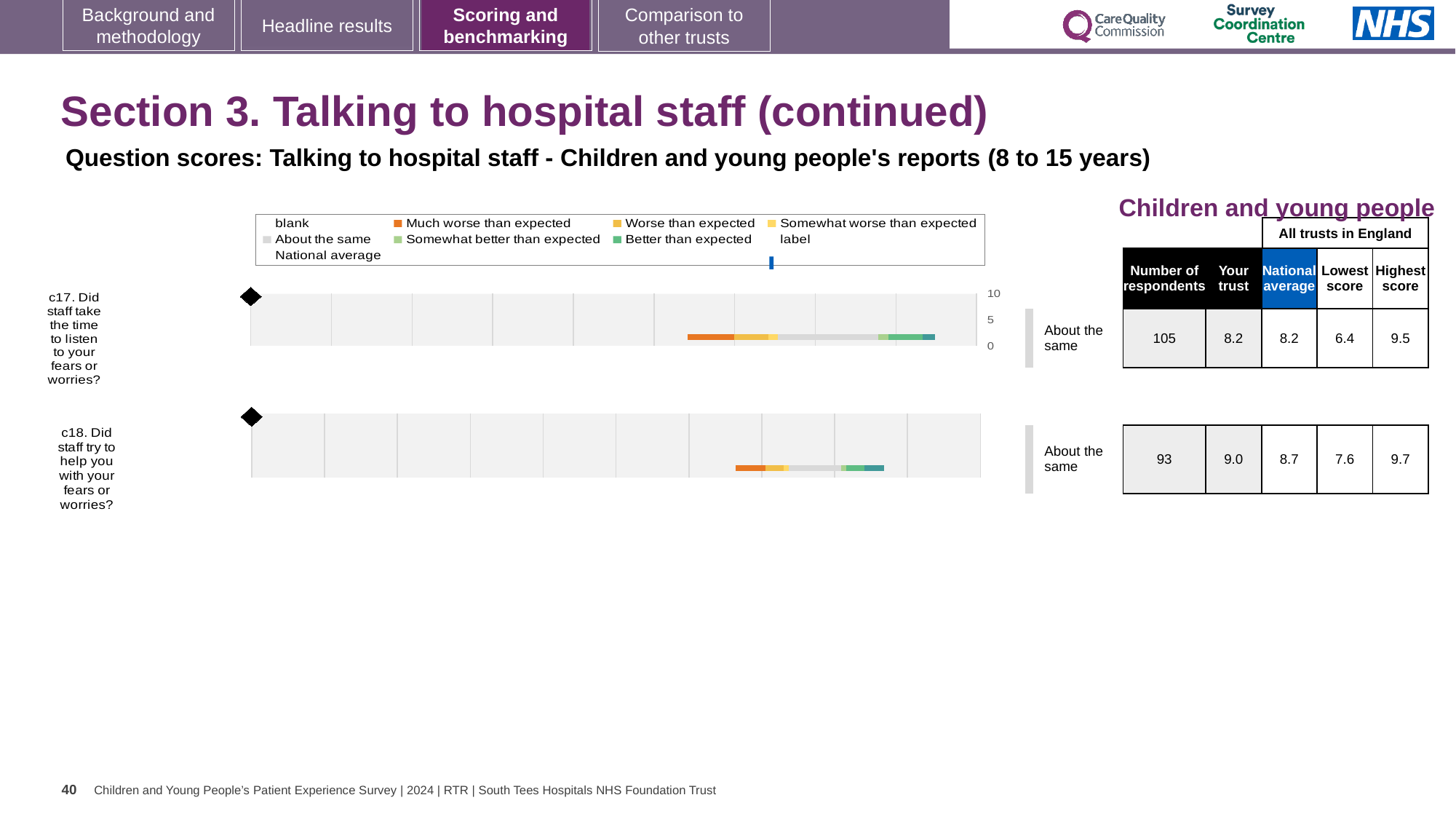
What is the trust's score for question c17 (Did staff take the time to listen to your fears or worries?)? 8.2 What is the national average score for question c18 (Did staff try to help you with your fears or worries?)? 8.7 What is the difference between the trust's score for c18 and its score for c17? 0.8 What benchmark category is shown for question c18? About the same What is the lowest score among all trusts in England for question c17? 6.4 How many questions are plotted on the slide? 2 Which question has the higher trust score, c17 or c18? c18 What is the highest score among all trusts in England for question c18? 9.7 Which legend entry is shown in orange? Much worse than expected What kind of chart is used to show the question scores? Bar chart How many respondents answered question c17? 105 Is the trust's score for question c18 greater or less than 5? greater